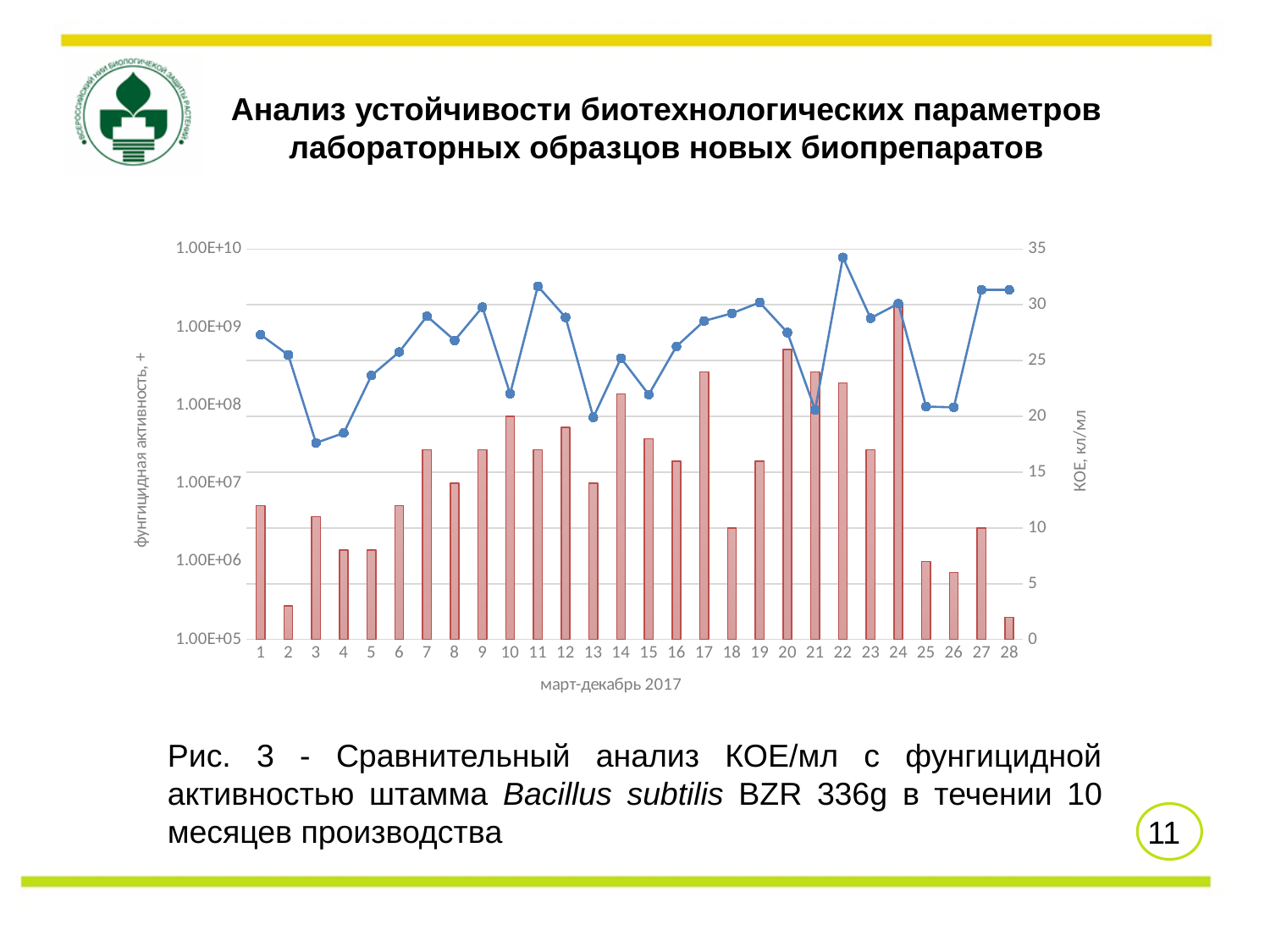
Which is higher on the line series, the point at category 22 or the point at category 3? 22 What is the title of the x axis of the chart? март-декабрь 2017 What is the title of the right-hand vertical axis of the chart? КОЕ, кл/мл Does the line series rise or fall from category 1 to category 3? fall How many categories are shown along the x axis of the chart? 28 What kind of chart is shown on the slide? A combined bar and line chart Which bar is taller, the one at category 17 or the one at category 18? 17 Which category has the tallest bar? 24 On the right-hand axis, is the bar at category 2 greater or less than 5? less At which category does the line series reach its highest point? 22